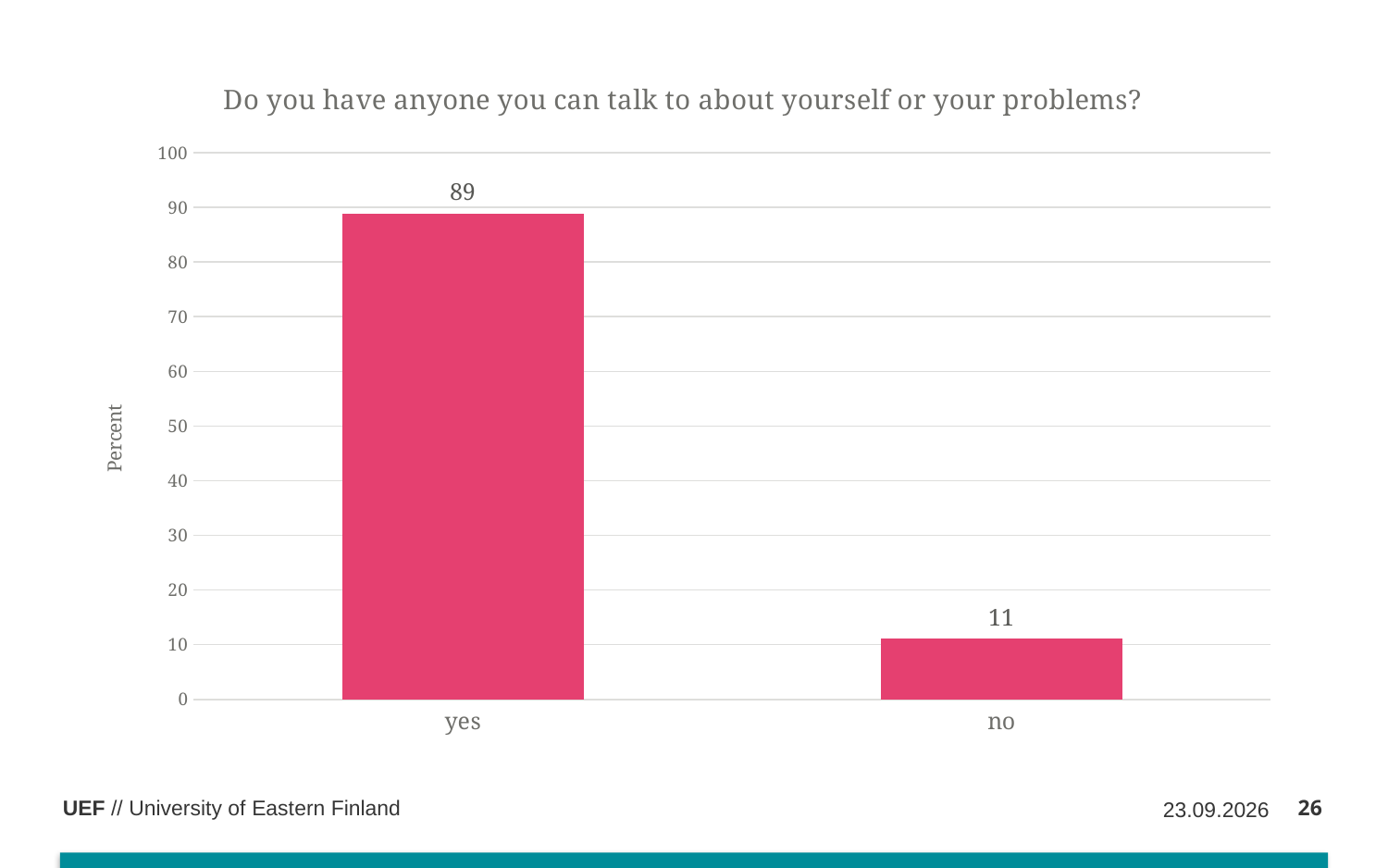
What is the difference between the values for "yes" and "no"? 78 What is the title of the chart? Do you have anyone you can talk to about yourself or your problems? Is the value for "yes" greater or less than 80? greater Which is larger, the value for "yes" or the value for "no"? yes Which category has the highest value? yes What is the label of the y axis? Percent How many categories are shown on the x axis? 2 Which category has the lowest value? no Is the value for "no" greater or less than 20? less What is the value for "no"? 11 What kind of chart is shown on the slide? bar chart What is the value for "yes"? 89